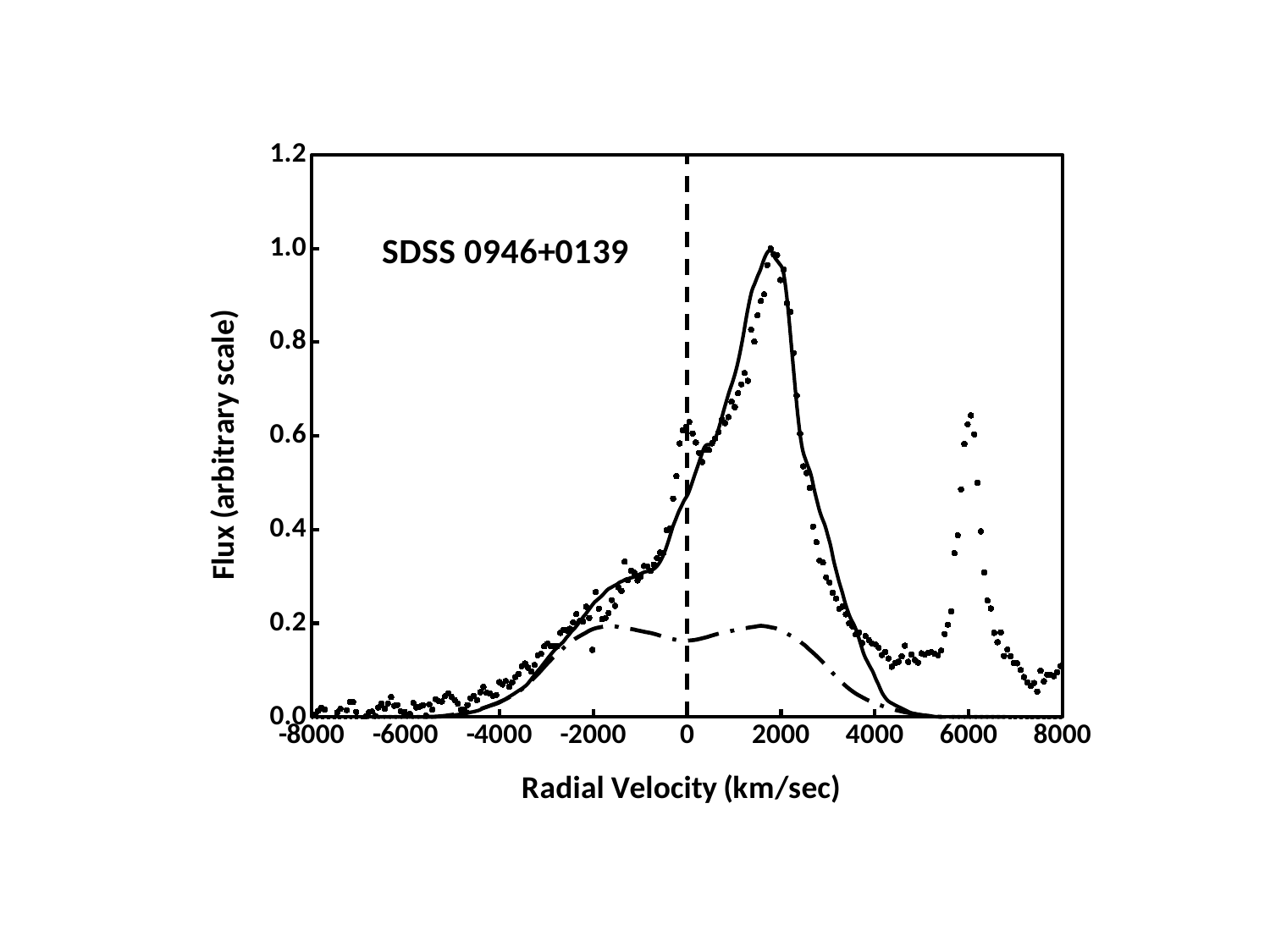
Is the value of the dash-dot line at a radial velocity of 4000 km/sec greater or less than 0.2? less Is the value of the solid line at a radial velocity of 2000 km/sec greater or less than 0.8? greater Is the value of the solid line at a radial velocity of -4000 km/sec greater or less than 0.2? less What kind of chart is shown on the slide? line chart At what radial velocity is the vertical dashed line drawn? 0 What object name is printed inside the plot area? SDSS 0946+0139 Which is higher: the peak of the dotted data points near 2000 km/sec or the peak of the dotted data points near 6000 km/sec? the peak near 2000 km/sec Does the solid line rise or fall as radial velocity increases from 2000 to 4000 km/sec? fall Does the solid line rise or fall as radial velocity increases from -4000 to 0 km/sec? rise